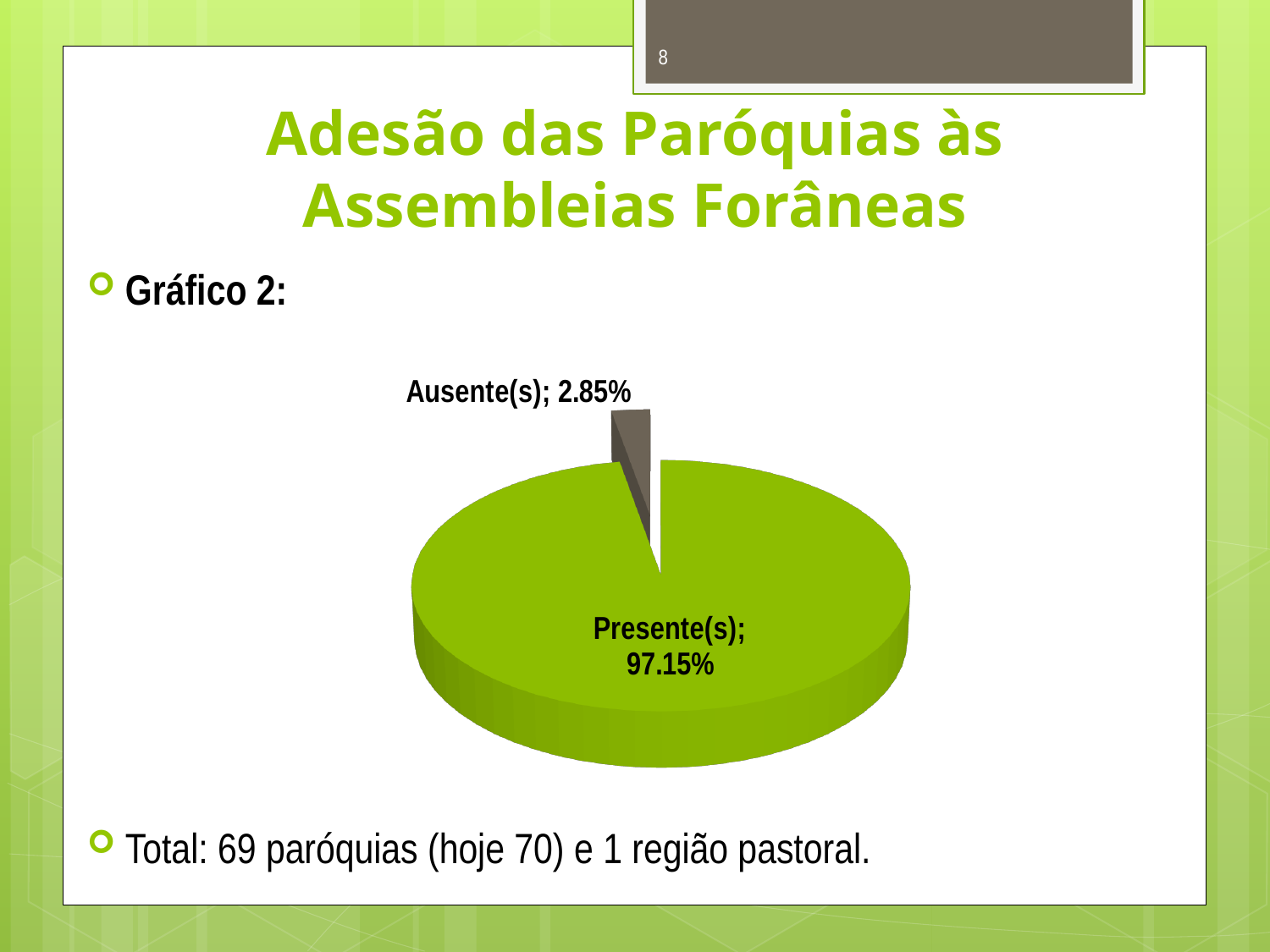
Which is larger, the Presente(s) slice or the Ausente(s) slice? Presente(s) How many slices does the pie chart have? 2 What is the share for Presente(s) in the pie chart? 97.15% What is the difference in percentage points between Presente(s) and Ausente(s)? 94.30% What colour is the Presente(s) slice in the pie chart? green Which slice of the pie chart is the largest? Presente(s) Which slice of the pie chart is the smallest? Ausente(s) What kind of chart is shown on the slide? pie chart What colour is the Ausente(s) slice in the pie chart? brown What is the share for Ausente(s) in the pie chart? 2.85%